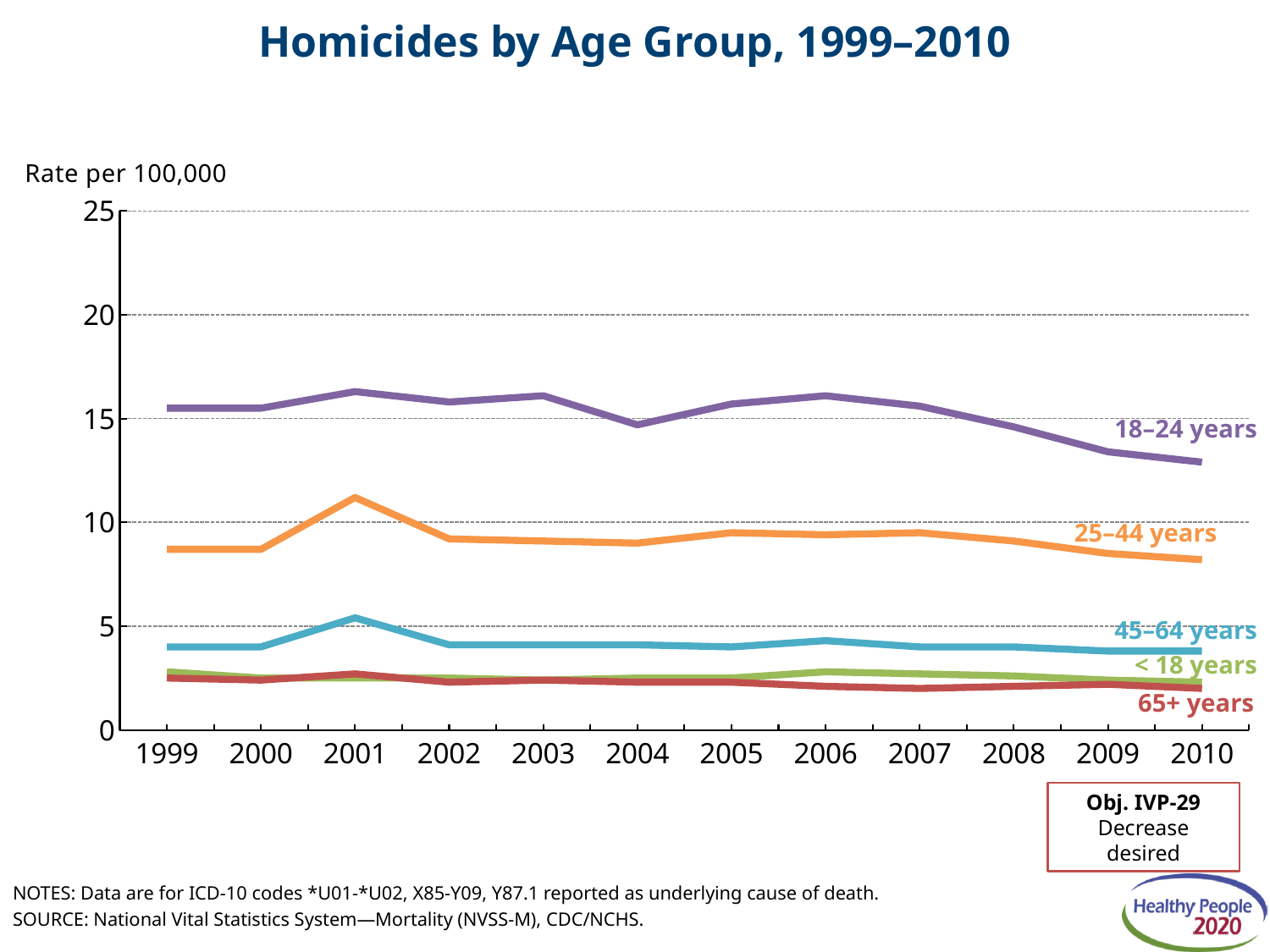
How many years are shown along the x axis? 12 Which age group has the highest homicide rate across all years shown? 18–24 years In 2005, which has the higher rate: 18–24 years or 25–44 years? 18–24 years Does the rate for 18–24 years rise or fall from 2006 to 2010? Fall Is the rate for 18–24 years in 2001 greater or less than 15? greater Is the rate for 25–44 years in 2010 greater or less than 10? less Is the rate for 25–44 years in 2001 greater or less than 10? greater What unit is the y axis labelled in? Rate per 100,000 What kind of chart is shown on the slide? Line chart How many age-group series are plotted on the chart? 5